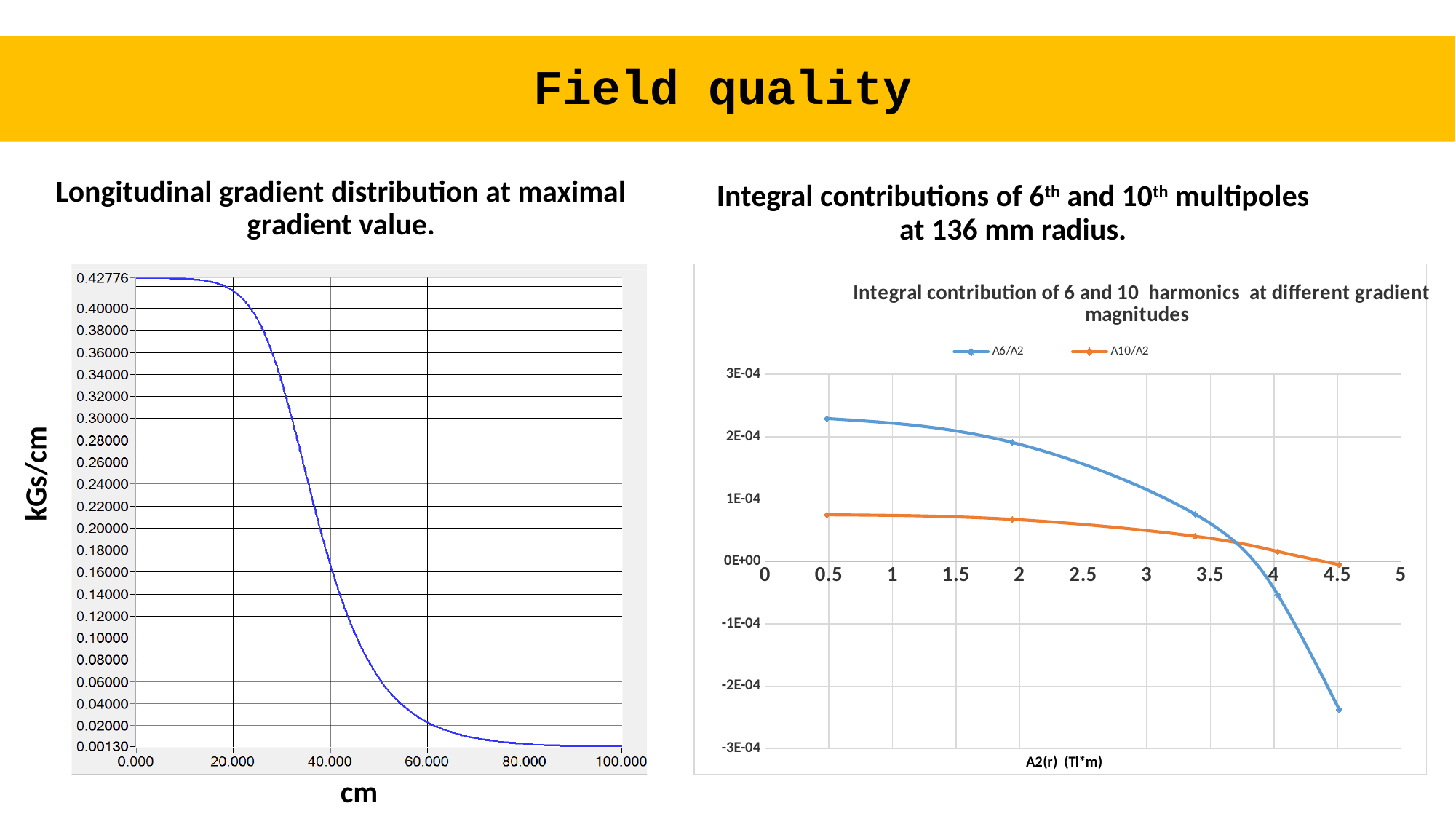
In the left chart, what is the label of the vertical axis? kGs/cm In the left chart, is the value at 40.000 cm greater or less than 0.20000 kGs/cm? less In the right chart, which series has the higher value at A2(r) = 0.5? A6/A2 In the right chart, is the A6/A2 value at A2(r) = 4.5 greater or less than -2E-04? less In the left chart, what is the lowest value shown on the kGs/cm axis, where the curve ends at 100.000 cm? 0.00130 What kind of chart is the right chart, 'Integral contribution of 6 and 10 harmonics at different gradient magnitudes'? line chart In the left chart, does the gradient rise or fall as the position in cm increases? fall In the right chart, what is the label of the horizontal axis? A2(r) (Tl*m) In the right chart, is the A6/A2 value at A2(r) = 0.5 greater or less than 2E-04? greater In the left chart, what is the highest value shown on the kGs/cm axis, where the curve starts? 0.42776 What kind of chart is the left chart, 'Longitudinal gradient distribution at maximal gradient value'? line chart How many series does the legend of the right chart list? 2